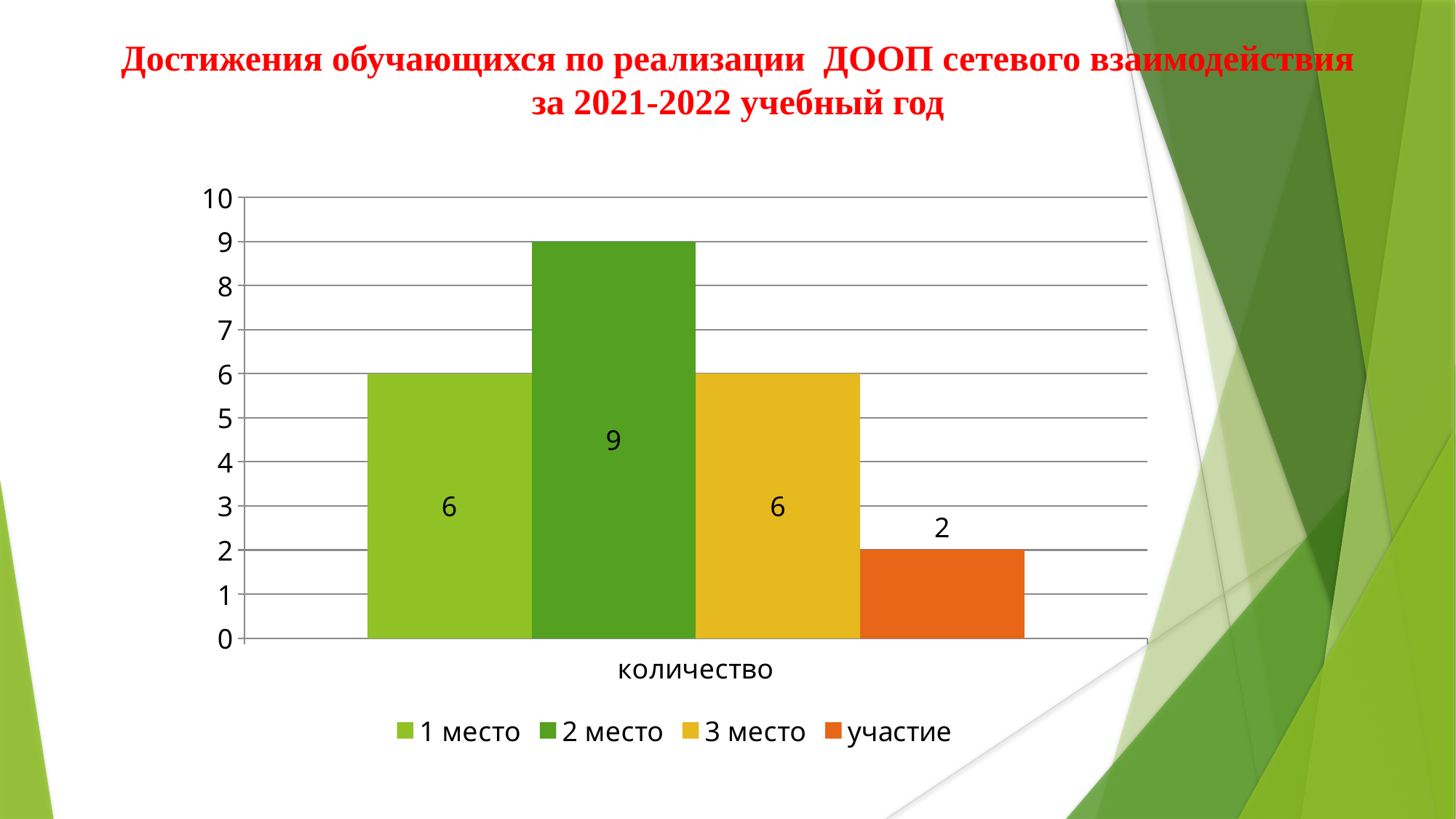
What kind of chart is shown on the slide? bar chart How many series does the legend list? 4 Which series has the lowest value? участие What is the difference between the values for 2 место and участие? 7 What is the value for 1 место? 6 What is the value for 2 место? 9 What is the label on the x axis category? количество What colour is the bar for участие? orange What is the difference between the values for 2 место and 3 место? 3 Which is larger, the value for 3 место or the value for участие? 3 место Which series has the highest value? 2 место What is the value for участие? 2